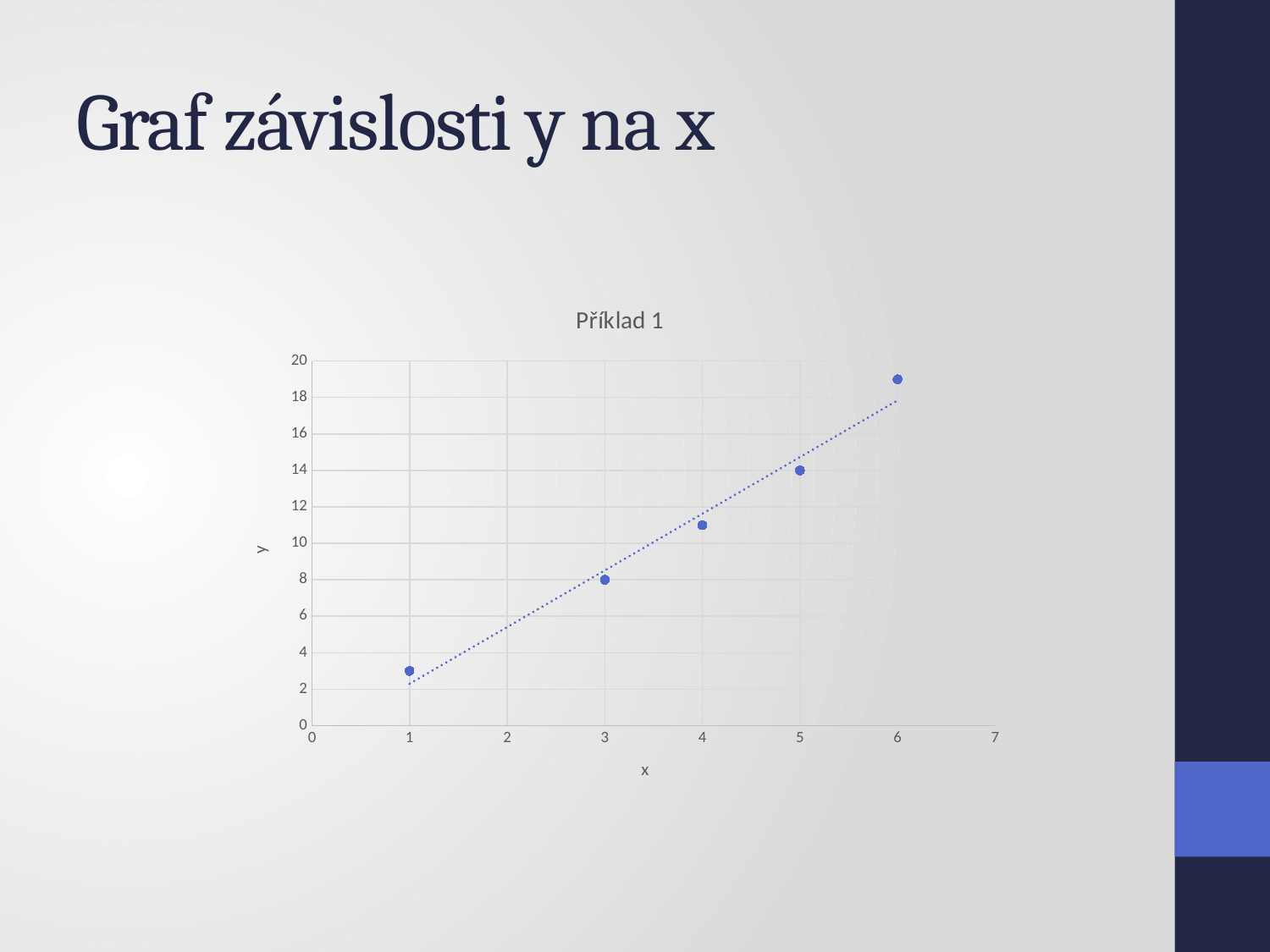
At which x value is the y value highest? 6 What kind of chart is shown on the slide? scatter chart What is the y value of the point at x = 3? 8 At which x value is the y value lowest? 1 What is the title of the chart? Příklad 1 How many data points are plotted in the chart? 5 What is the y value of the point at x = 5? 14 Which point has the larger y value, the one at x = 3 or the one at x = 5? x = 5 Is the y value of the point at x = 4 greater or less than 10? greater Do the y values rise or fall as x increases? rise Is the y value of the point at x = 1 greater or less than 4? less Is the y value of the point at x = 6 greater or less than 18? greater